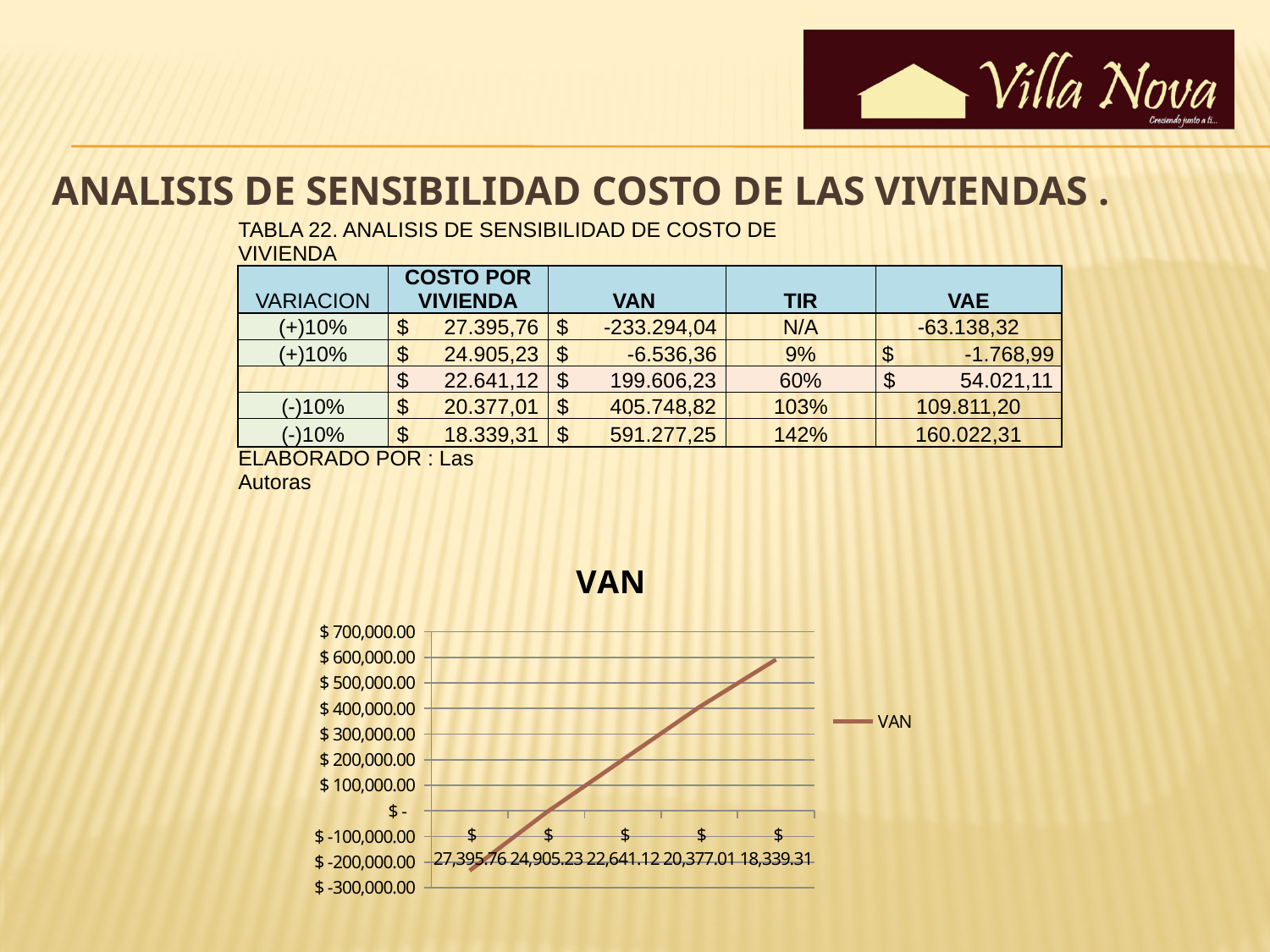
Is the VAN value for $ 18,339.31 greater or less than $ 500,000.00? greater Is the VAN value for $ 27,395.76 greater or less than $ -200,000.00? less At which x-axis category is the VAN value lowest? $ 27,395.76 Which has the larger VAN value, $ 18,339.31 or $ 27,395.76? $ 18,339.31 What is the title of the chart? VAN Does the VAN line rise or fall from left to right along the x axis? rises How many series does the chart legend list? 1 At which x-axis category is the VAN value highest? $ 18,339.31 How many points are plotted on the VAN line? 5 What kind of chart is shown on the slide? line chart Is the VAN value for $ 20,377.01 greater or less than $ 300,000.00? greater